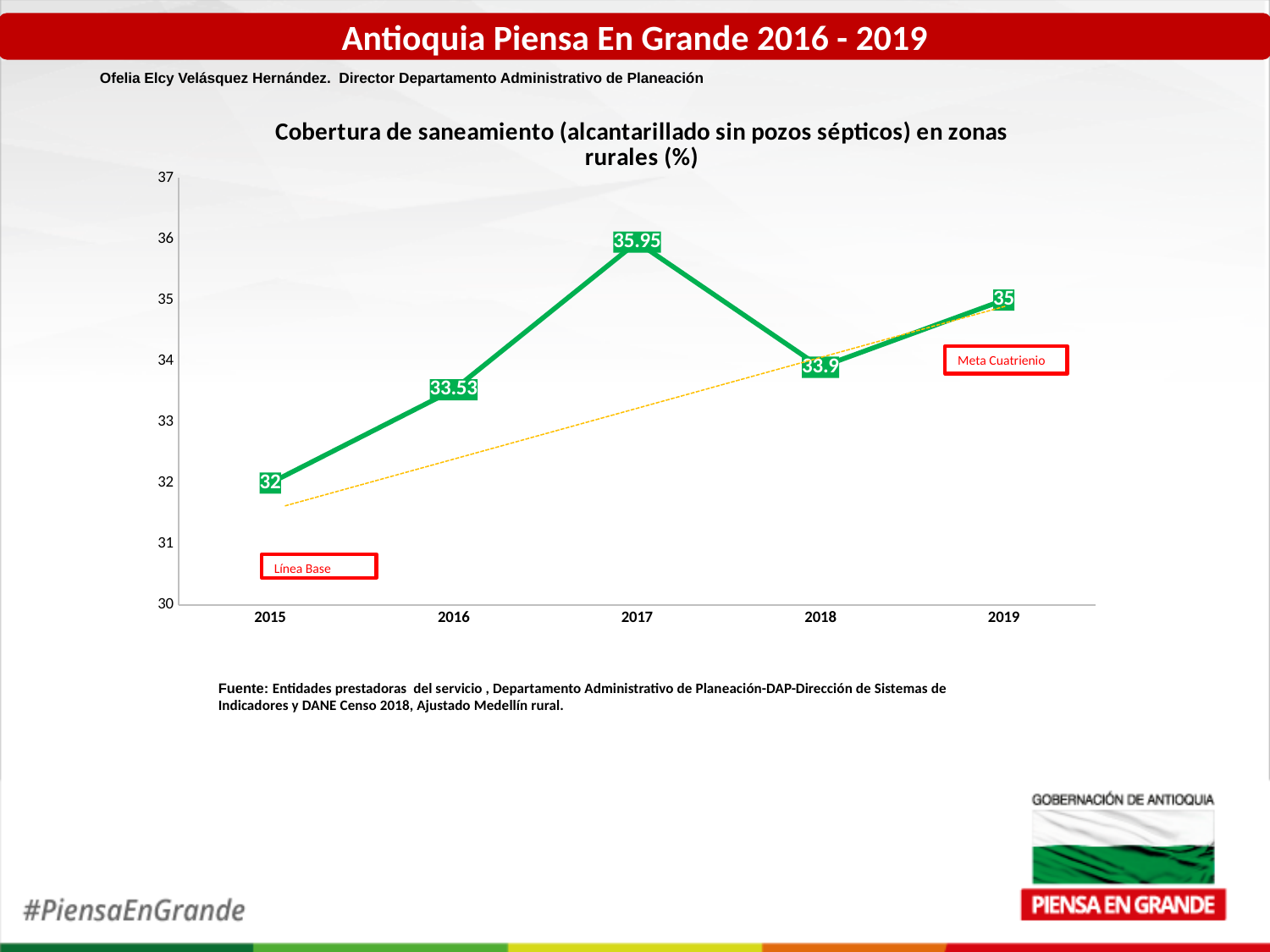
Is the value for 2016 greater or less than 34? less What is the value for 2018? 33.9 How many years are plotted on the x axis? 5 Which year has the lowest value? 2015 What is the difference between the values for 2017 and 2018? 2.05 What is the value for 2015? 32 What is the value for 2019? 35 Which year has the highest value? 2017 What kind of chart is shown? line chart Which is larger, the value for 2016 or the value for 2018? 2018 What is the value for 2017? 35.95 Does the value rise or fall from 2017 to 2018? fall